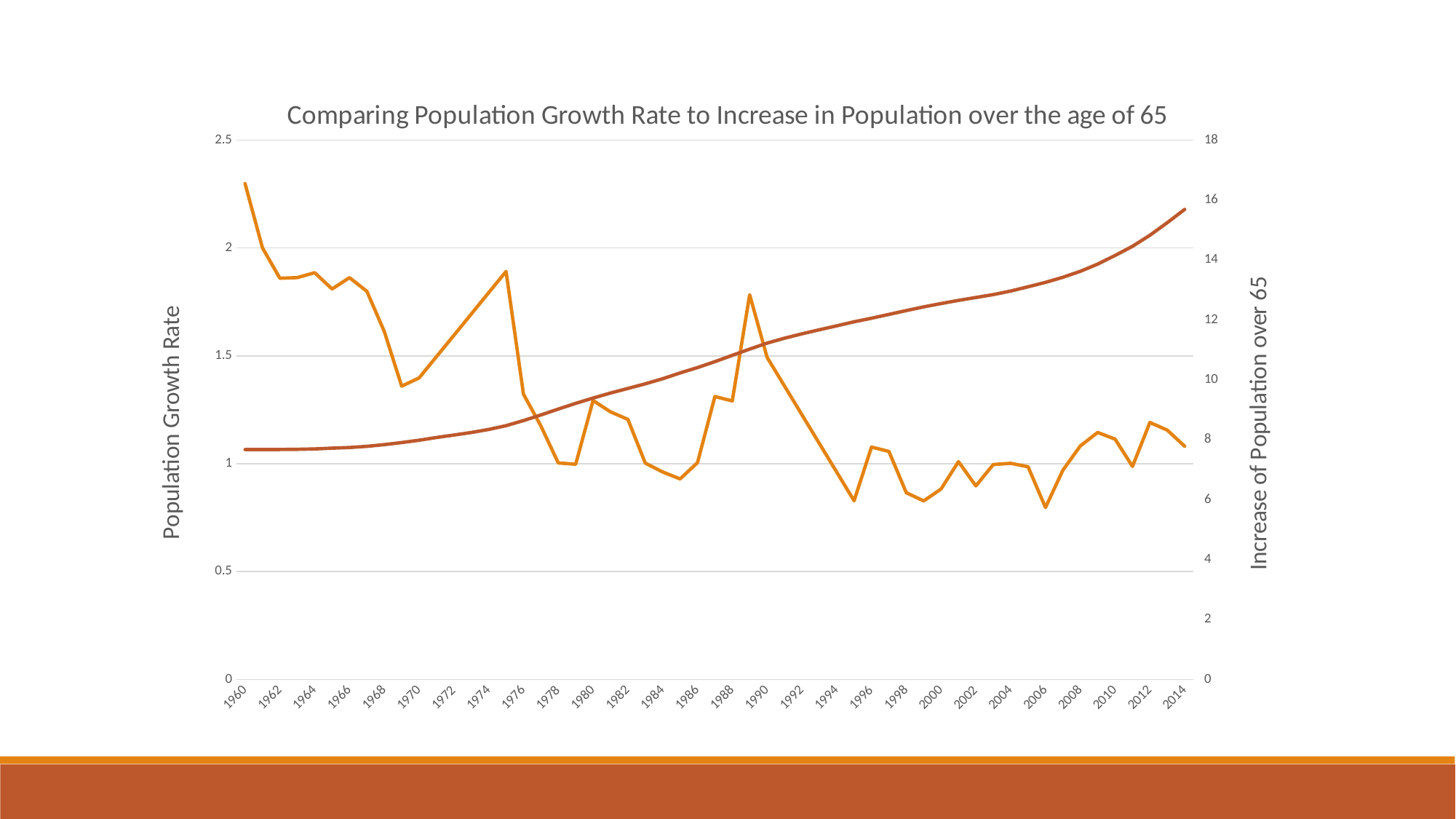
What kind of chart is shown on the slide? line chart Does the Increase of Population over 65 line rise or fall from 1960 to 2014? rise Is the Population Growth Rate value for 1960 greater or less than 2? greater How many lines are plotted on the chart? 2 In which year does the Population Growth Rate line reach its highest value? 1960 How many year labels are shown along the x axis? 28 What is the title of the chart? Comparing Population Growth Rate to Increase in Population over the age of 65 Is the Population Growth Rate value for 1995 greater or less than 1? less Is the Population Growth Rate value for 1969 greater or less than 1.5? less What is the title of the right-hand vertical axis? Increase of Population over 65